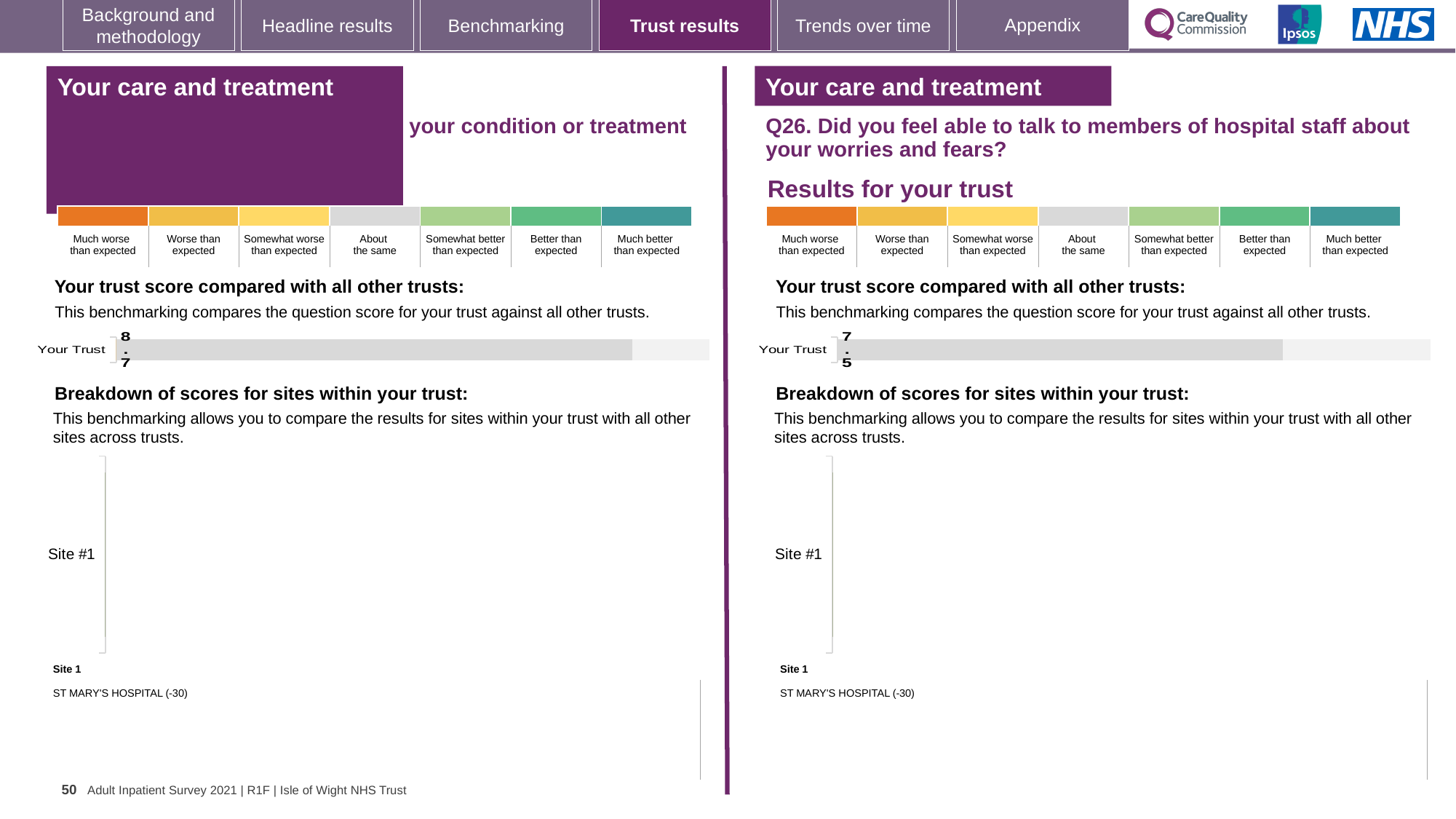
On the right-hand chart (Q26, worries and fears), what is the score shown for Your Trust? 7.5 On the right-hand Q26 chart, how many categories does the colour key above the chart list, from 'Much worse than expected' to 'Much better than expected'? 7 On the right-hand Q26 chart, how many sites are listed in the breakdown of scores for sites within your trust? 1 What is the difference between the Your Trust score on the left-hand chart (8.7) and on the right-hand Q26 chart (7.5)? 1.2 On the left-hand chart, how many sites are listed in the breakdown of scores for sites within your trust? 1 Which panel shows the higher Your Trust score, the left-hand chart or the right-hand Q26 chart? the left-hand chart What kind of chart is used to show the Your Trust score on the right-hand Q26 panel? bar chart Is the Your Trust score on the right-hand Q26 chart greater or less than 8? less On the left-hand chart (your condition or treatment), what is the score shown for Your Trust? 8.7 On the right-hand Q26 chart, which hospital is listed as Site 1? ST MARY'S HOSPITAL (-30)